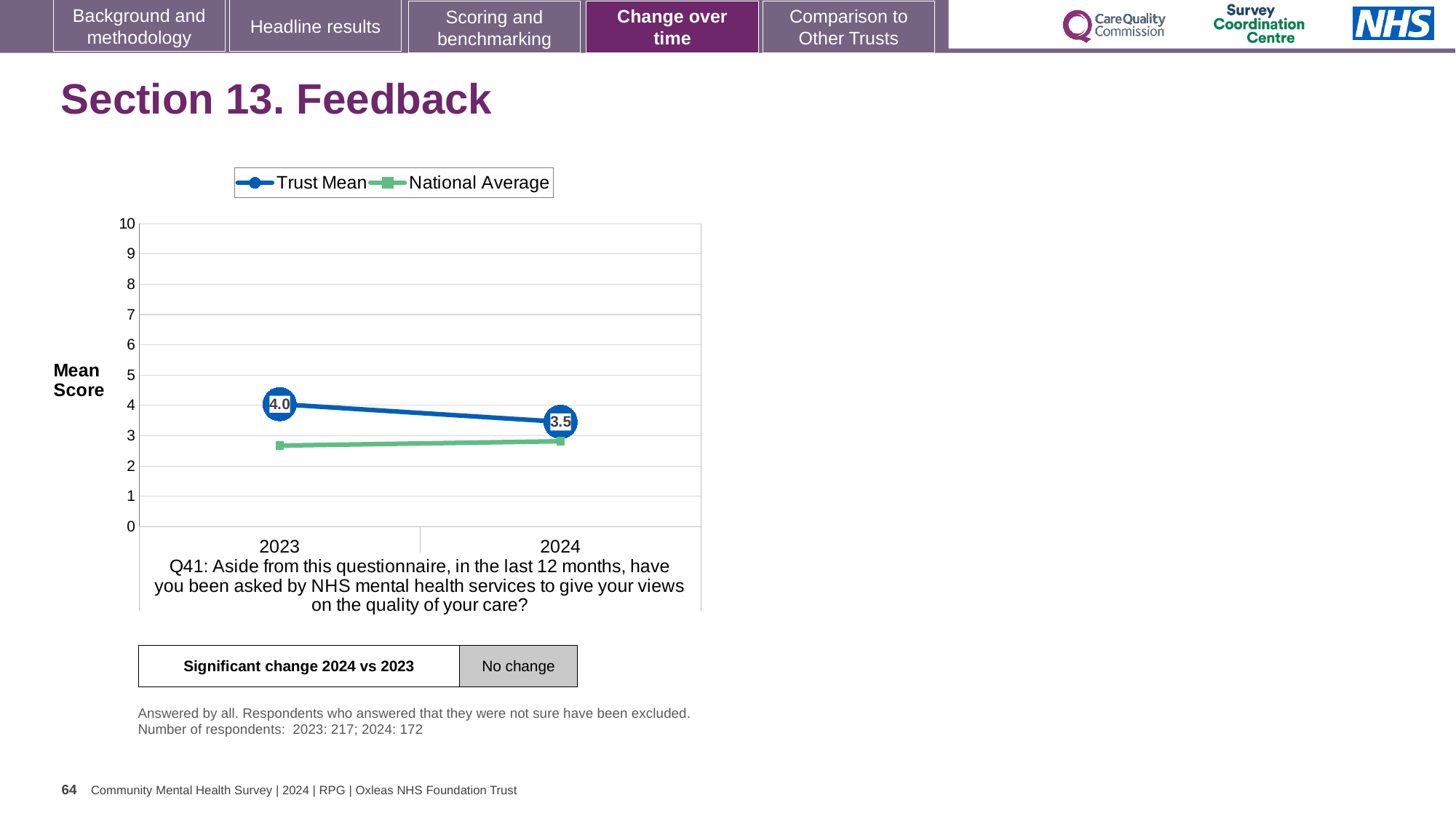
Does the Trust Mean rise or fall from 2023 to 2024? fall What is the Trust Mean value for 2024? 3.5 Is the National Average value for 2023 greater or less than 3? less How many years are plotted on the x axis? 2 In which year is the Trust Mean higher, 2023 or 2024? 2023 What is the label on the y axis of the chart? Mean Score What is the Trust Mean value for 2023? 4.0 What is the difference between the Trust Mean in 2023 and in 2024? 0.5 What kind of chart is shown on the slide? line chart How many series does the legend list? 2 Is the National Average value for 2024 greater or less than 2? greater In 2024, which is larger, the Trust Mean or the National Average? Trust Mean